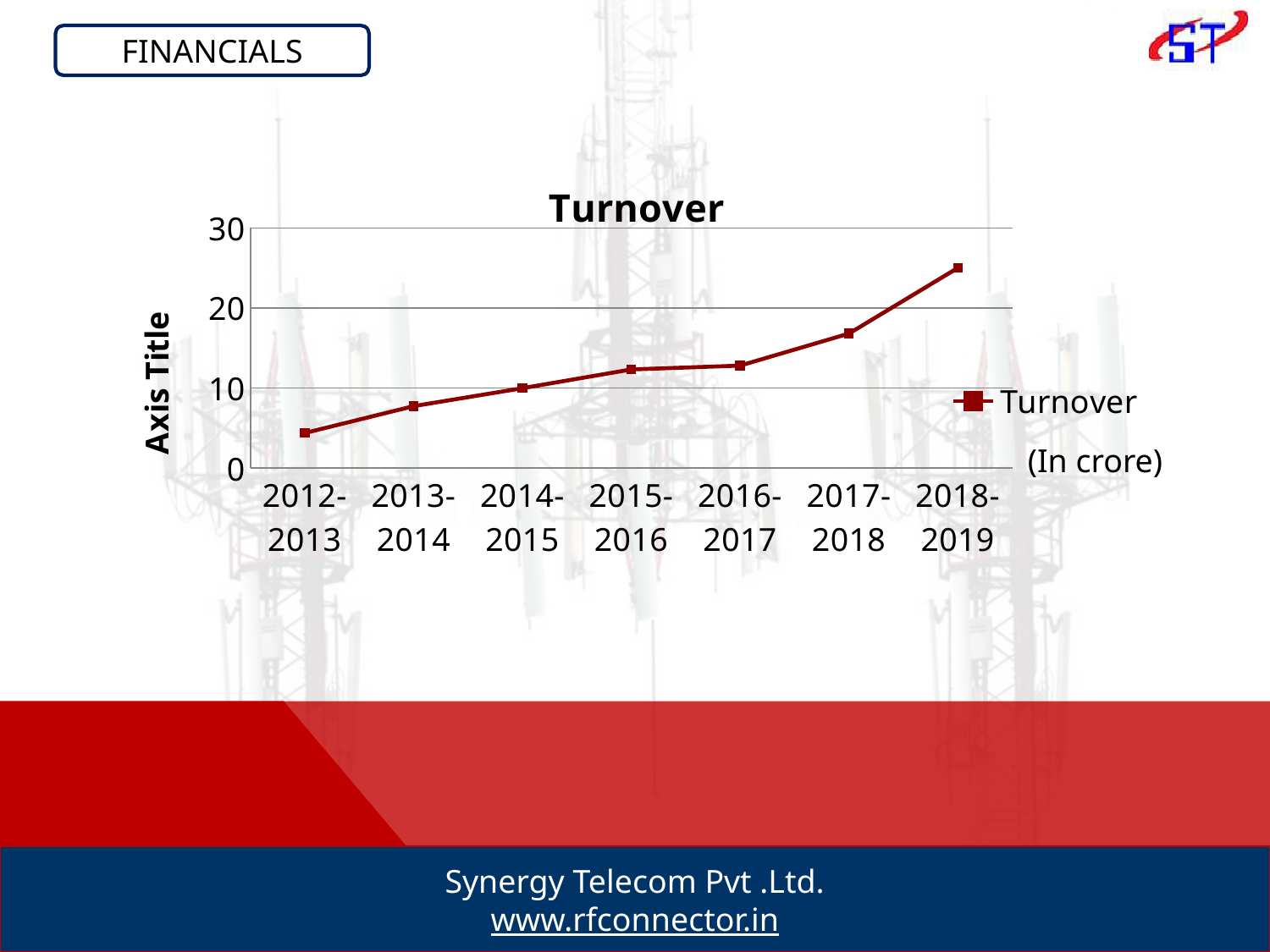
Does turnover rise or fall from 2012-2013 to 2018-2019? rise What unit is given next to the legend for the turnover values? In crore What kind of chart is shown on the slide? line chart How many series does the legend list? 1 Is the turnover for 2018-2019 greater or less than 20? greater Is the turnover for 2012-2013 greater or less than 10? less Which period has the highest turnover? 2018-2019 How many periods are plotted along the x axis? 7 Which period has the lowest turnover? 2012-2013 What is the title of the chart? Turnover Which is larger, the turnover for 2013-2014 or for 2017-2018? 2017-2018 Is the turnover for 2017-2018 greater or less than 20? less